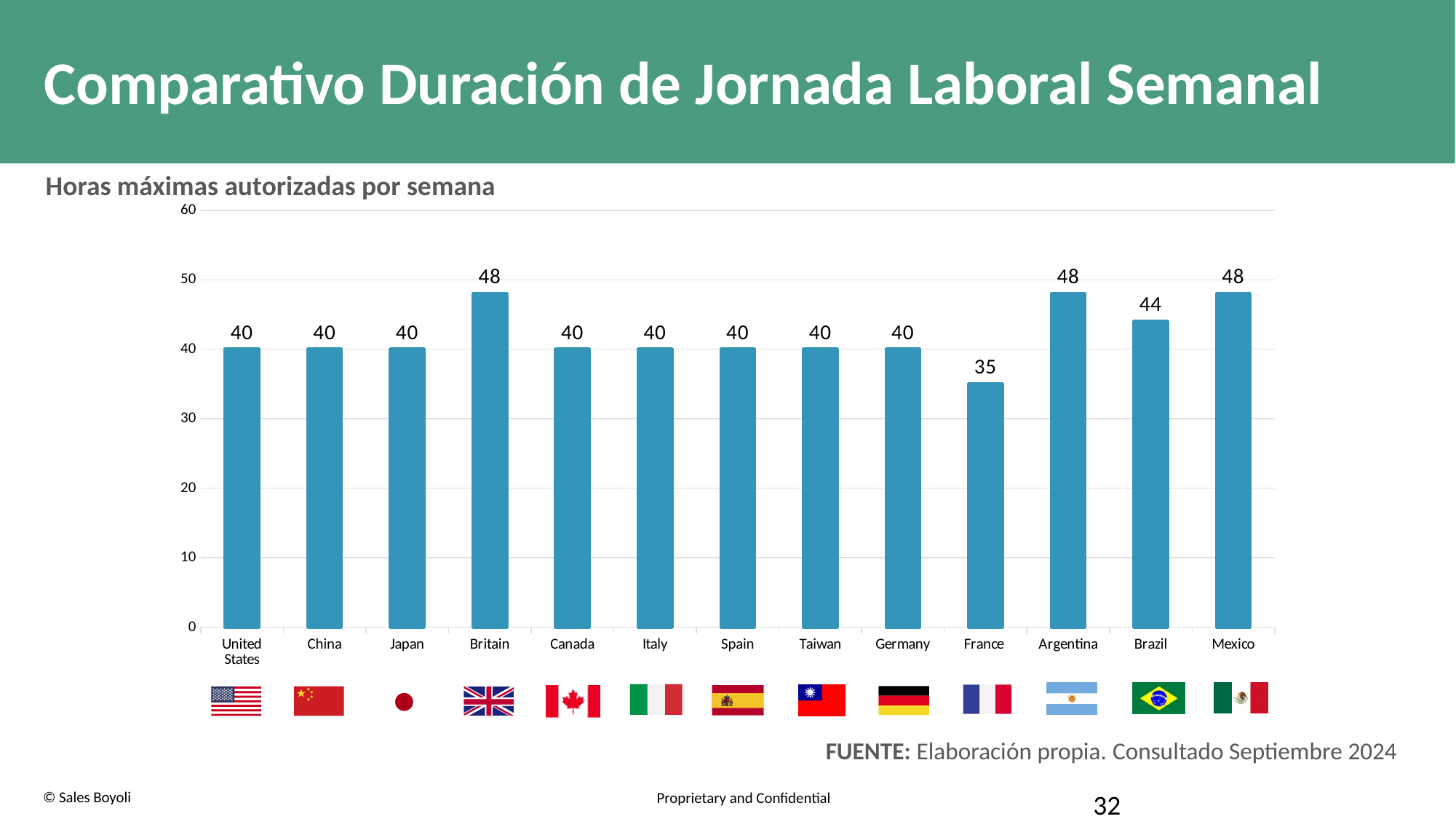
What is the difference between the values for Brazil and Canada? 4 What is the difference between the values for Mexico and France? 13 Which is larger, the value for Argentina or the value for Brazil? Argentina What is the value for Brazil? 44 Which country has the lowest value? France What kind of chart is shown on the slide? bar chart What is the subtitle shown above the chart? Horas máximas autorizadas por semana What is the value for France? 35 What is the value for Britain? 48 What is the value for Japan? 40 Is the value for France greater or less than 40? less How many countries are shown on the chart? 13